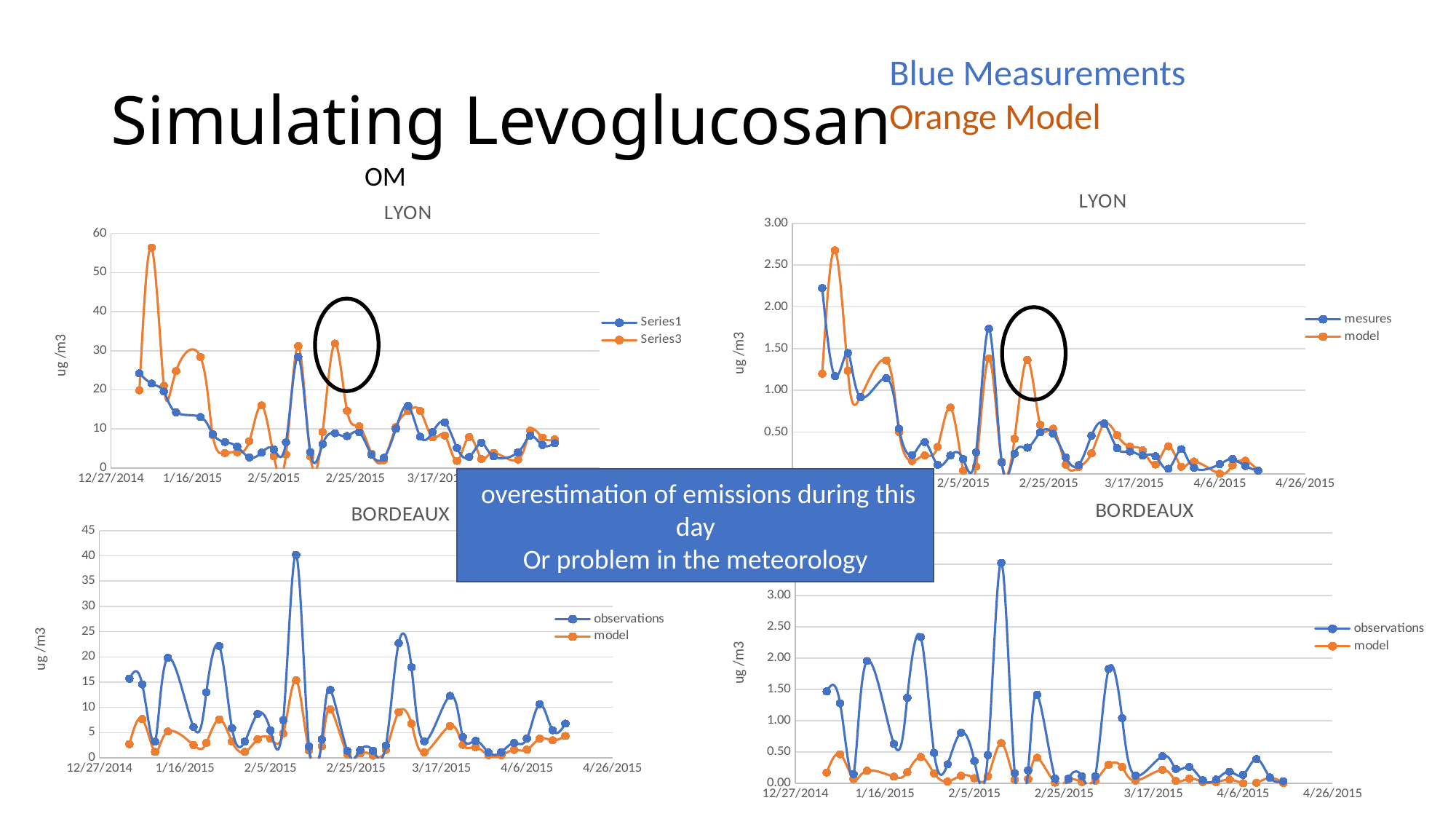
In the bottom-left BORDEAUX chart, is the highest observations value greater or less than 35? greater In the bottom-right BORDEAUX chart, do the observations values generally rise or fall from January to April 2015? fall How many series does the legend of the top-left LYON chart list? 2 What are the legend entries of the top-left LYON chart? Series1, Series3 What kind of chart is the top-left LYON chart? line chart In the bottom-left BORDEAUX chart, is the highest model value greater or less than 20? less In the top-right LYON chart, which series reaches the higher peak value, mesures or model? model In the top-right LYON chart, is the highest model value greater or less than 2.50? greater What are the legend entries of the top-right LYON chart? mesures, model In the bottom-right BORDEAUX chart, which series reaches the higher peak value, observations or model? observations